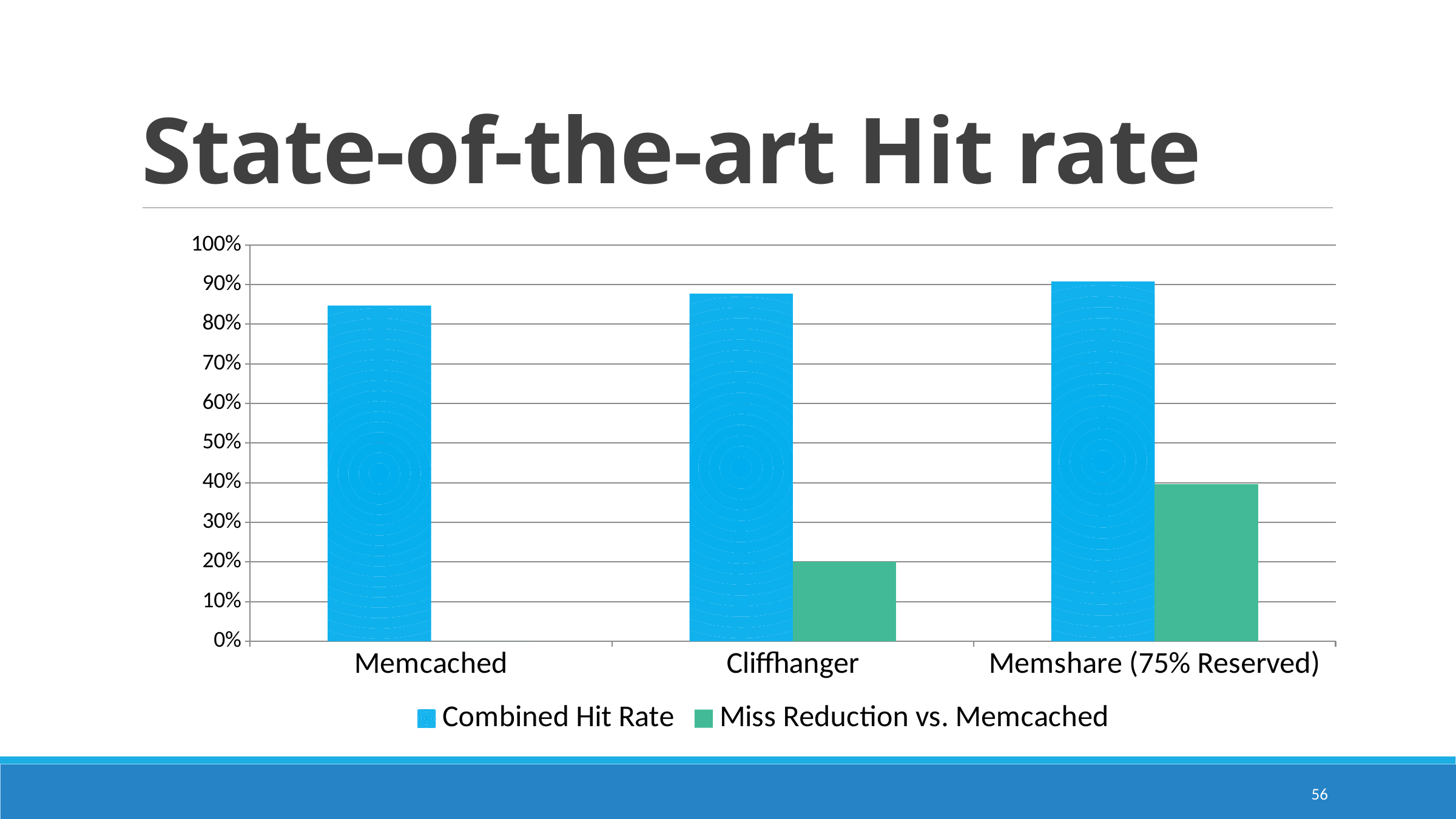
Which category has the highest Combined Hit Rate? Memshare (75% Reserved) Is the Combined Hit Rate for Cliffhanger greater or less than 90%? less What kind of chart is shown on the slide? bar chart Which category has the lowest Combined Hit Rate? Memcached What is the title of the slide containing the chart? State-of-the-art Hit rate Does the Combined Hit Rate rise or fall from Memcached to Memshare (75% Reserved) along the x axis? rise Is the Miss Reduction vs. Memcached for Cliffhanger greater or less than 30%? less Is the Miss Reduction vs. Memcached for Memshare (75% Reserved) greater or less than 30%? greater Which has a larger Miss Reduction vs. Memcached, Cliffhanger or Memshare (75% Reserved)? Memshare (75% Reserved) How many categories are shown on the x axis? 3 How many series does the legend list? 2